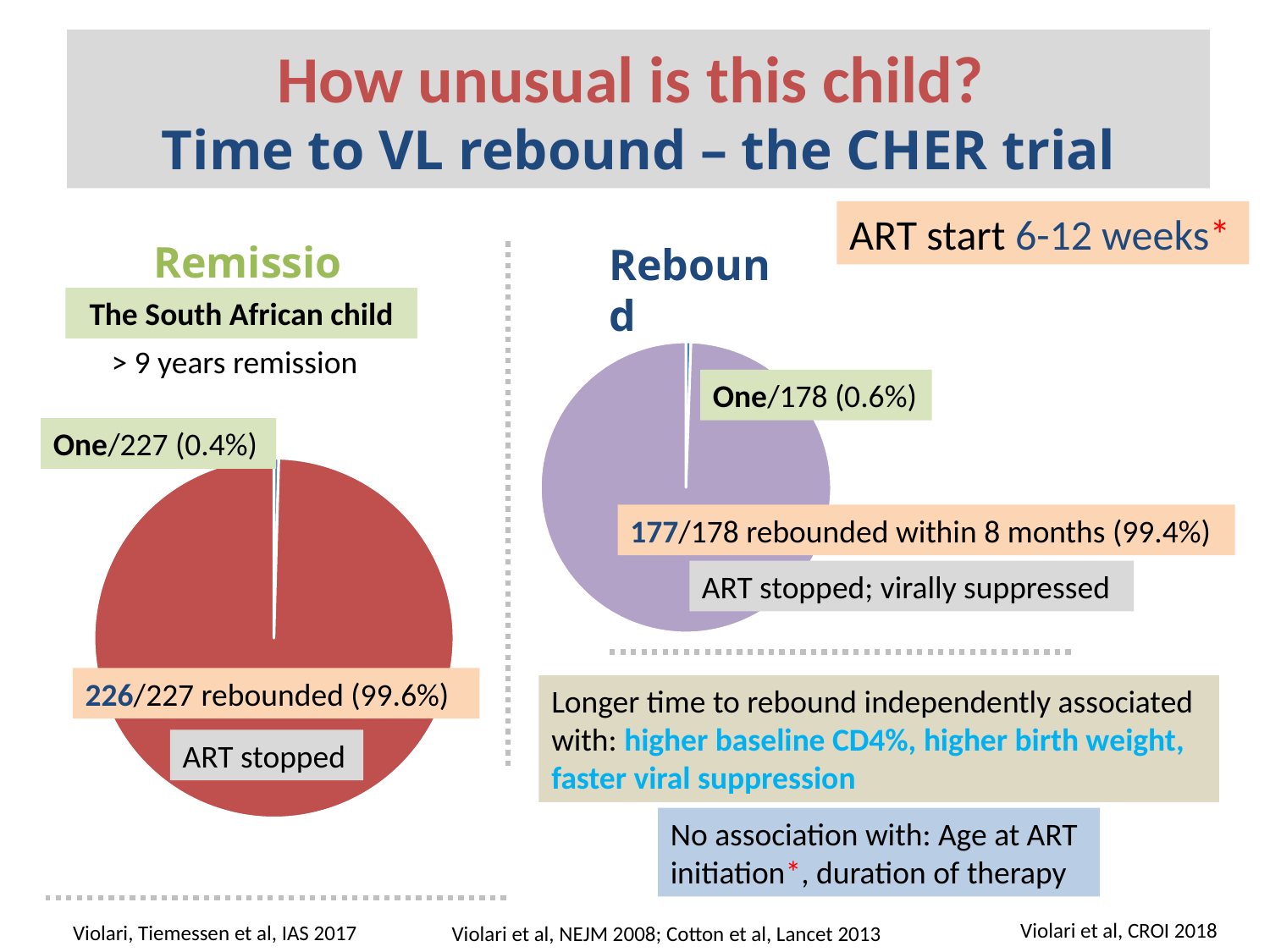
In the right pie chart, what share of children is represented by the single non-rebound case? 0.6% What is the difference between the number of children who rebounded in the left pie chart (226) and in the right pie chart (177)? 49 What colour is the large slice of the left pie chart? red In the right pie chart, how many children out of 178 rebounded within 8 months? 177 In the right pie chart, what share of children rebounded within 8 months? 99.4% How many slices does the left pie chart have? 2 What type of chart is shown on the left side of the slide? pie chart In the left pie chart, what share of children rebounded? 99.6% What colour is the large slice of the right pie chart? purple In the right pie chart, which slice is larger: the 177/178 rebounded slice or the One/178 slice? 177/178 rebounded In the left pie chart, how many children out of 227 rebounded? 226